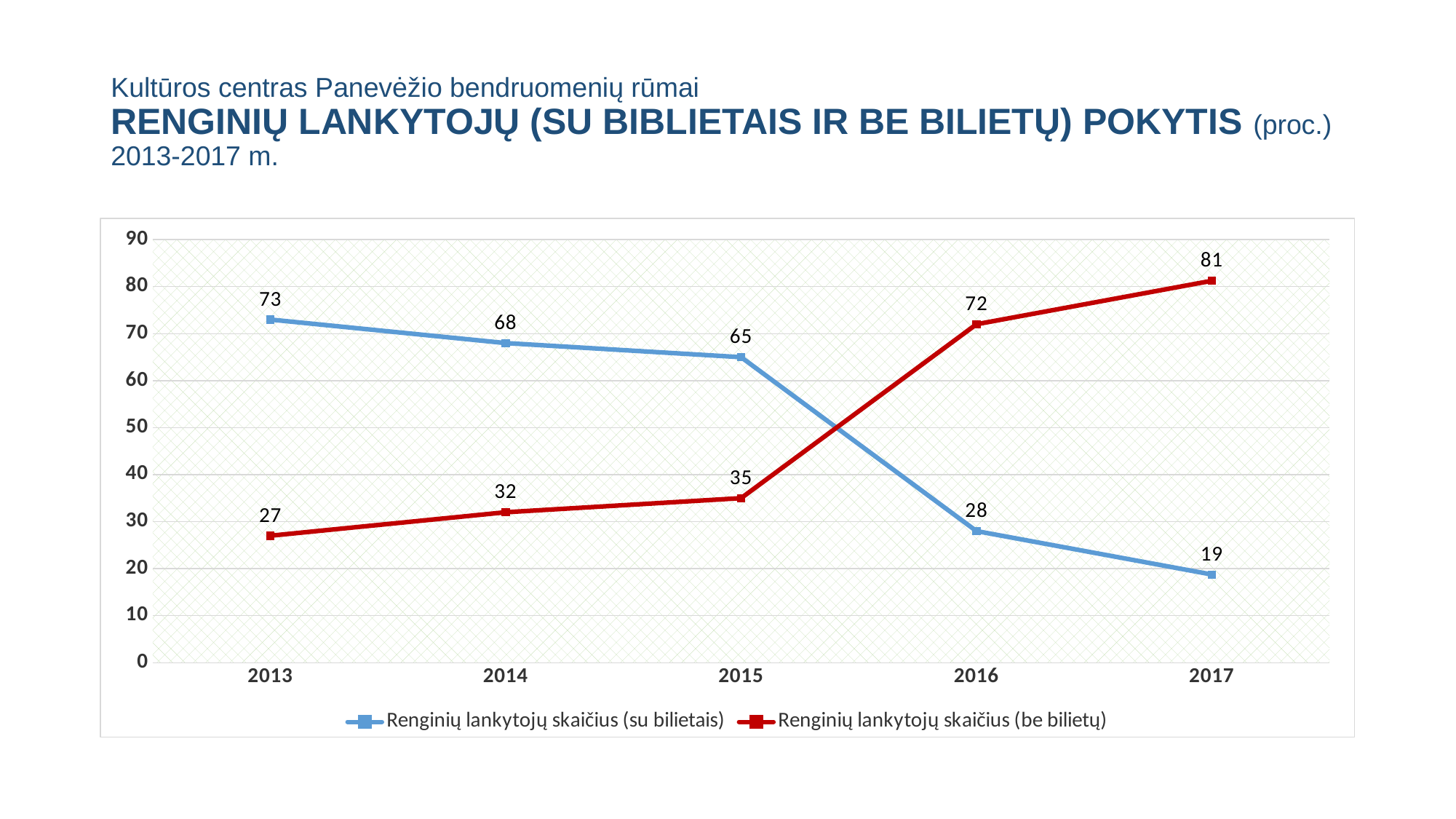
What colour is the line for 'Renginių lankytojų skaičius (be bilietų)'? Red Does the 'Renginių lankytojų skaičius (su bilietais)' series rise or fall from 2013 to 2017? Fall What is the value for 'Renginių lankytojų skaičius (be bilietų)' in 2017? 81 What is the difference between the 'be bilietų' and 'su bilietais' values in 2016? 44 What is the value for 'Renginių lankytojų skaičius (be bilietų)' in 2015? 35 In which year is 'Renginių lankytojų skaičius (be bilietų)' highest? 2017 Which series has the larger value in 2014, 'su bilietais' or 'be bilietų'? Renginių lankytojų skaičius (su bilietais) How many series does the legend list? 2 What is the value for 'Renginių lankytojų skaičius (su bilietais)' in 2013? 73 In which year is 'Renginių lankytojų skaičius (su bilietais)' lowest? 2017 What kind of chart is shown on the slide? Line chart How many years are plotted on the x axis? 5